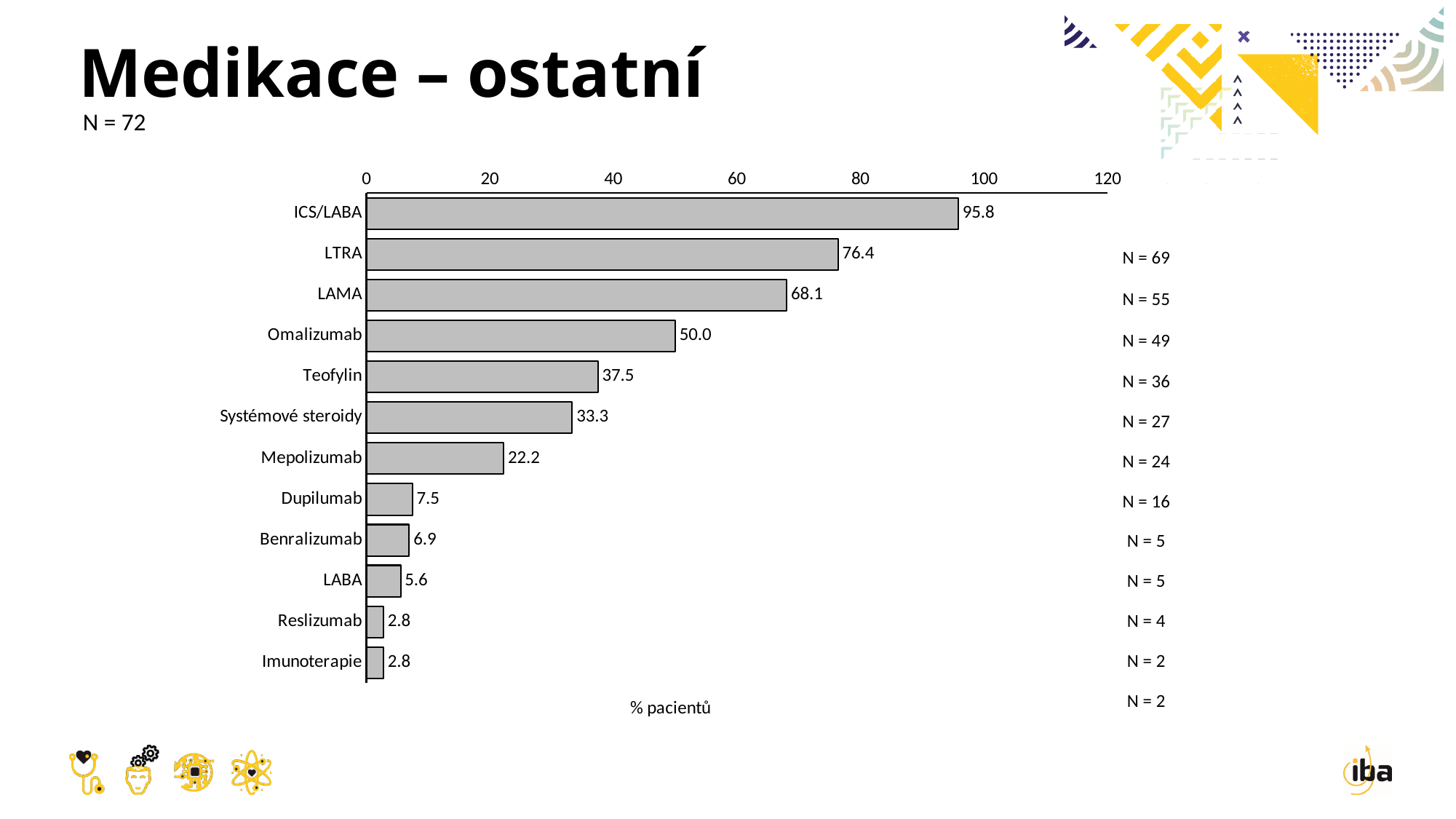
What is the label of the horizontal axis? % pacientů What kind of chart is shown on the slide? bar chart Which is larger, the value for Teofylin or the value for Systémové steroidy? Teofylin What is the value for ICS/LABA? 95.8 What is the value for Omalizumab? 50.0 What is the difference between the values for LTRA and LAMA? 8.3 How many categories are shown in the chart? 12 Is the value for LAMA greater or less than 60? greater What is the difference between the values for Dupilumab and LABA? 1.9 Which category has the highest value? ICS/LABA What is the value for Mepolizumab? 22.2 What is the value for Benralizumab? 6.9